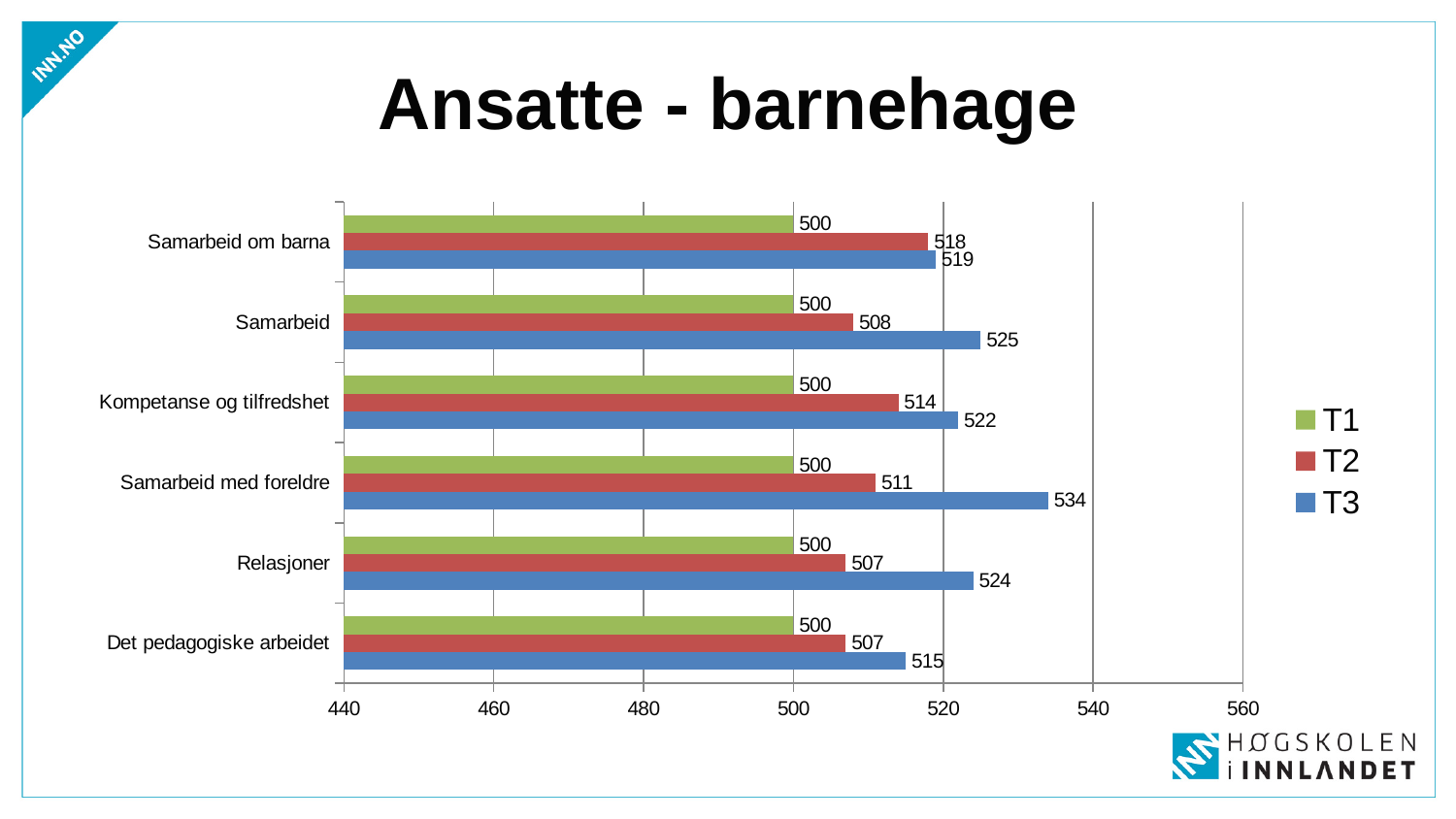
Which category has the highest T2 value? Samarbeid om barna What is the T3 value for Samarbeid med foreldre? 534 What is the T2 value for Kompetanse og tilfredshet? 514 What is the difference between the T3 and T2 values for Samarbeid? 17 Which category has the highest T3 value? Samarbeid med foreldre How many categories are shown on the chart? 6 What is the title of the slide? Ansatte - barnehage What is the T3 value for Det pedagogiske arbeidet? 515 Which is larger: the T3 value for Relasjoner or the T3 value for Kompetanse og tilfredshet? Relasjoner How many series does the legend list? 3 What kind of chart is shown on the slide? Bar chart Which category has the lowest T3 value? Det pedagogiske arbeidet